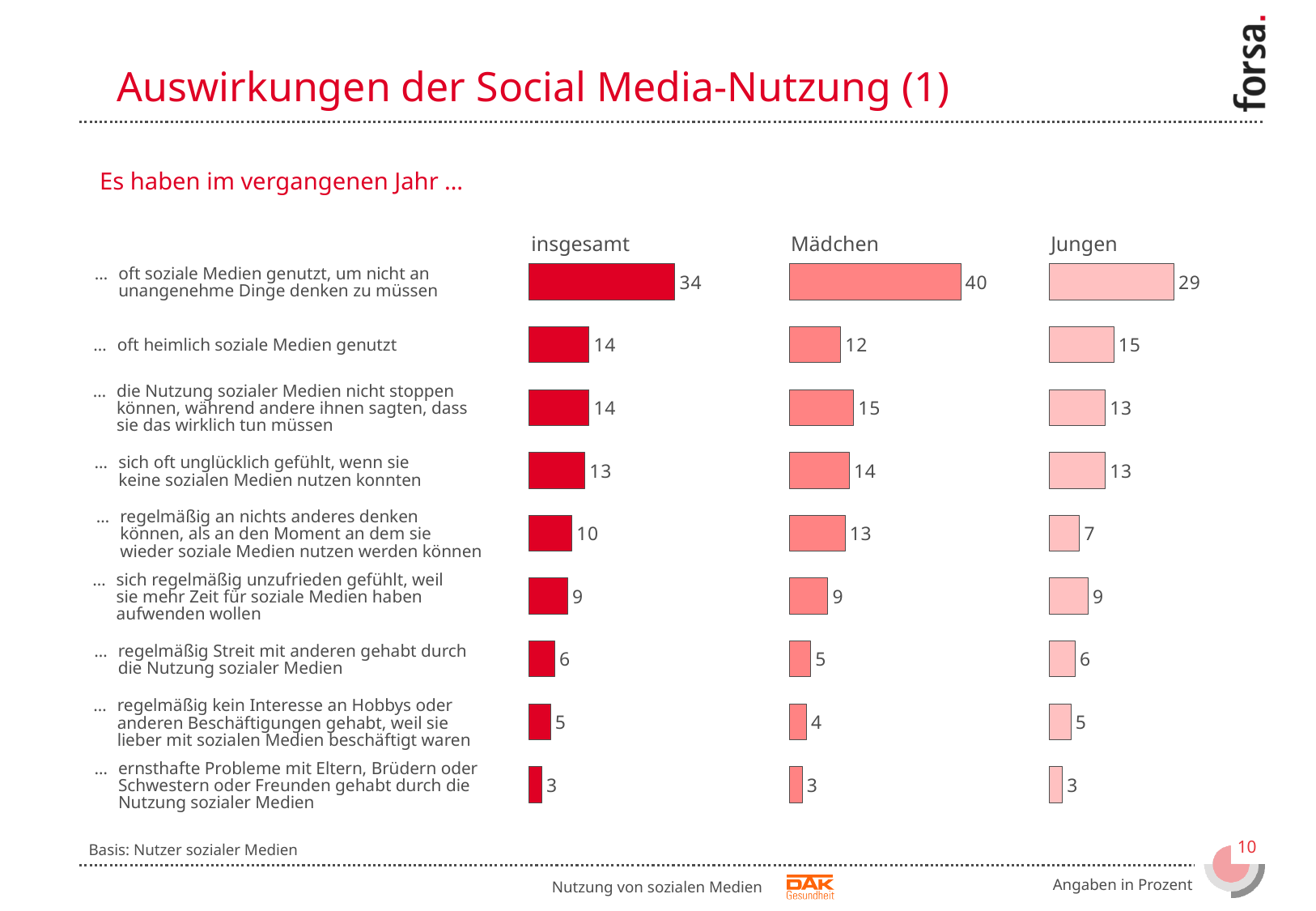
In the "Mädchen" chart, what is the value for "oft heimlich soziale Medien genutzt"? 12 What is the difference between the "Mädchen" and "Jungen" values for "oft soziale Medien genutzt, um nicht an unangenehme Dinge denken zu müssen"? 11 What are the titles of the three charts on the slide? insgesamt, Mädchen, Jungen In the "Jungen" chart, what is the value for "regelmäßig an nichts anderes denken können, als an den Moment an dem sie wieder soziale Medien nutzen werden können"? 7 What kind of chart is used on this slide? bar chart In the "insgesamt" chart, what is the value for "oft soziale Medien genutzt, um nicht an unangenehme Dinge denken zu müssen"? 34 In the "Mädchen" chart, what is the value for "regelmäßig kein Interesse an Hobbys oder anderen Beschäftigungen gehabt, weil sie lieber mit sozialen Medien beschäftigt waren"? 4 For "oft heimlich soziale Medien genutzt", which is larger: the "Mädchen" value or the "Jungen" value? Jungen In the "Mädchen" chart, which category has the highest value? oft soziale Medien genutzt, um nicht an unangenehme Dinge denken zu müssen How many categories are shown in the "insgesamt" chart? 9 In the "insgesamt" chart, what is the difference between "oft heimlich soziale Medien genutzt" and "regelmäßig Streit mit anderen gehabt durch die Nutzung sozialer Medien"? 8 In the "Jungen" chart, which category has the lowest value? ernsthafte Probleme mit Eltern, Brüdern oder Schwestern oder Freunden gehabt durch die Nutzung sozialer Medien